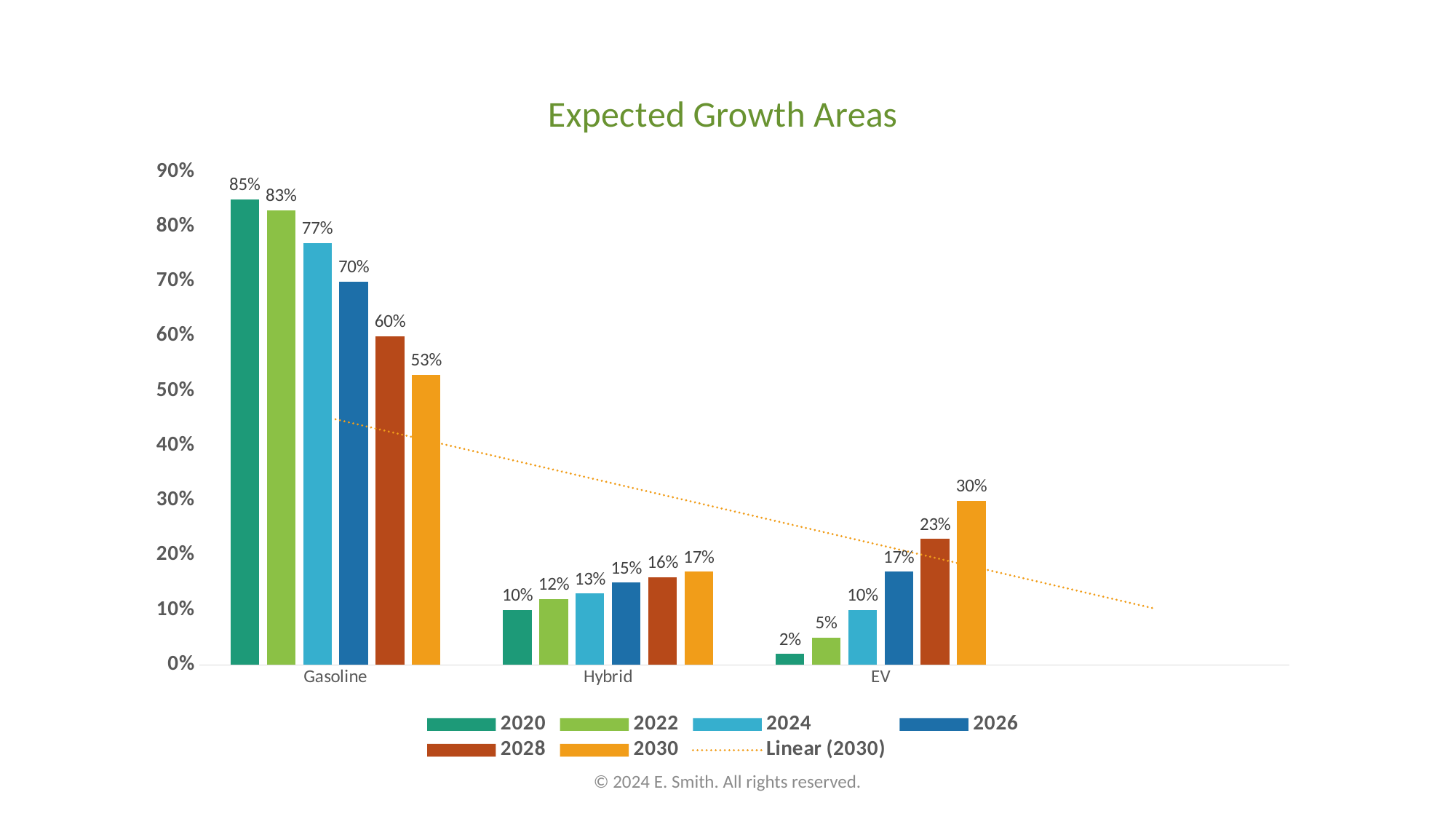
Which is larger: the EV value in 2030 or the Hybrid value in 2030? EV value in 2030 What kind of chart is shown on the slide? Bar chart What is the difference between the Gasoline values for 2020 and 2030? 32% Is the value for Gasoline in 2026 greater or less than 60%? greater Do the EV values rise or fall from 2020 to 2030? Rise What is the value for Hybrid in 2026? 15% How many entries does the legend list? 7 What is the value for Gasoline in 2020? 85% How many categories are shown on the x axis? 3 Which category has the lowest value in 2020? EV Which category has the highest value in 2028? Gasoline What is the value for EV in 2030? 30%